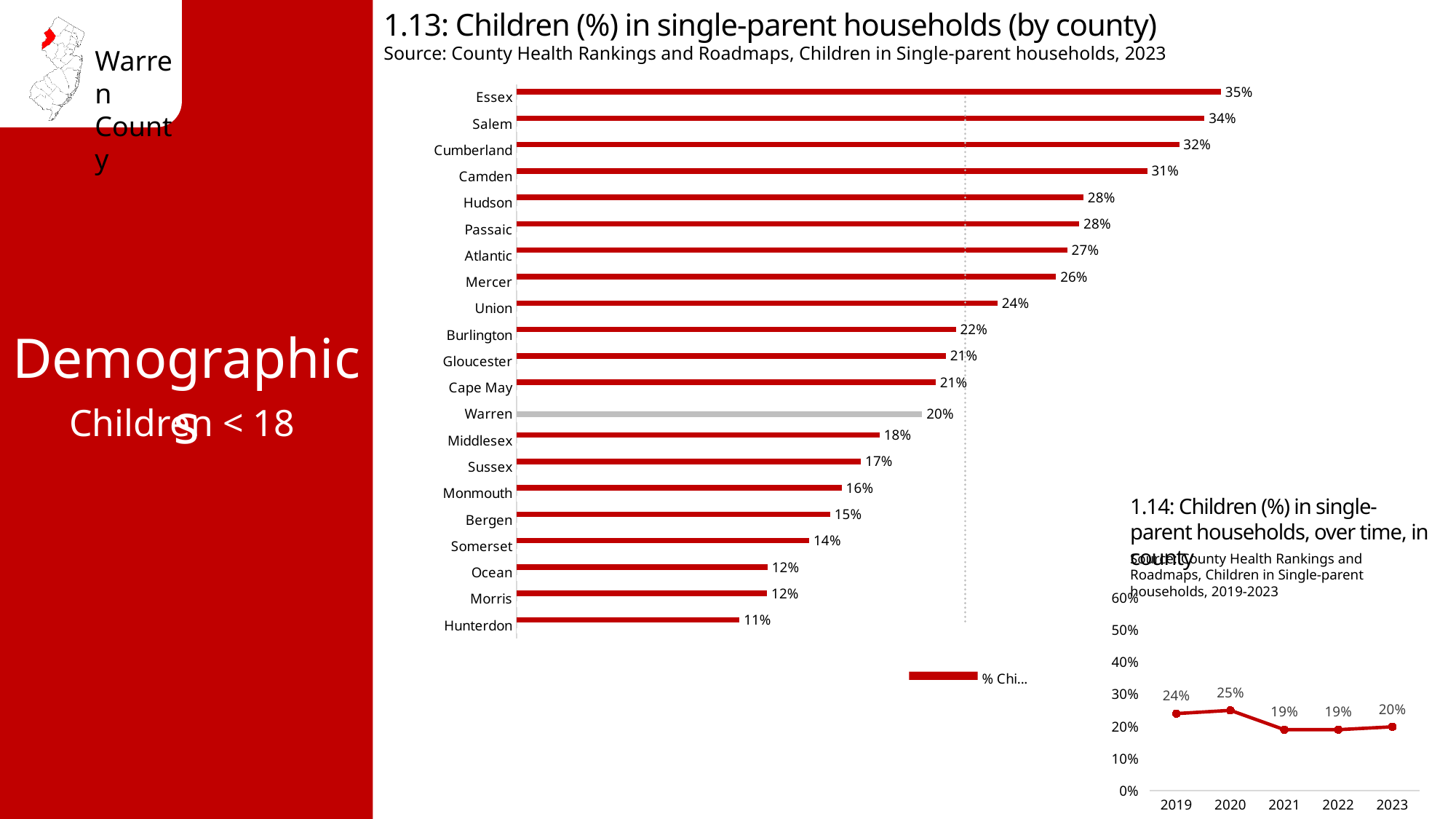
What kind of chart is chart 1.13 (by county)? Bar chart In chart 1.13 (Children (%) in single-parent households by county), what is the value for Warren? 20% In chart 1.13 (by county), which has a larger value, Union or Middlesex? Union In chart 1.13 (by county), which county has the highest value? Essex In chart 1.13 (by county), how many counties are shown? 21 In chart 1.14 (over time, in county), what is the value for 2020? 25% In chart 1.13 (by county), what is the difference between the values for Essex and Warren? 15% In chart 1.14 (over time, in county), which year has the highest value? 2020 In chart 1.13 (by county), what is the value for Camden? 31% In chart 1.14 (over time, in county), how many years are plotted? 5 What kind of chart is chart 1.14 (over time, in county)? Line chart In chart 1.13 (by county), which county has the lowest value? Hunterdon